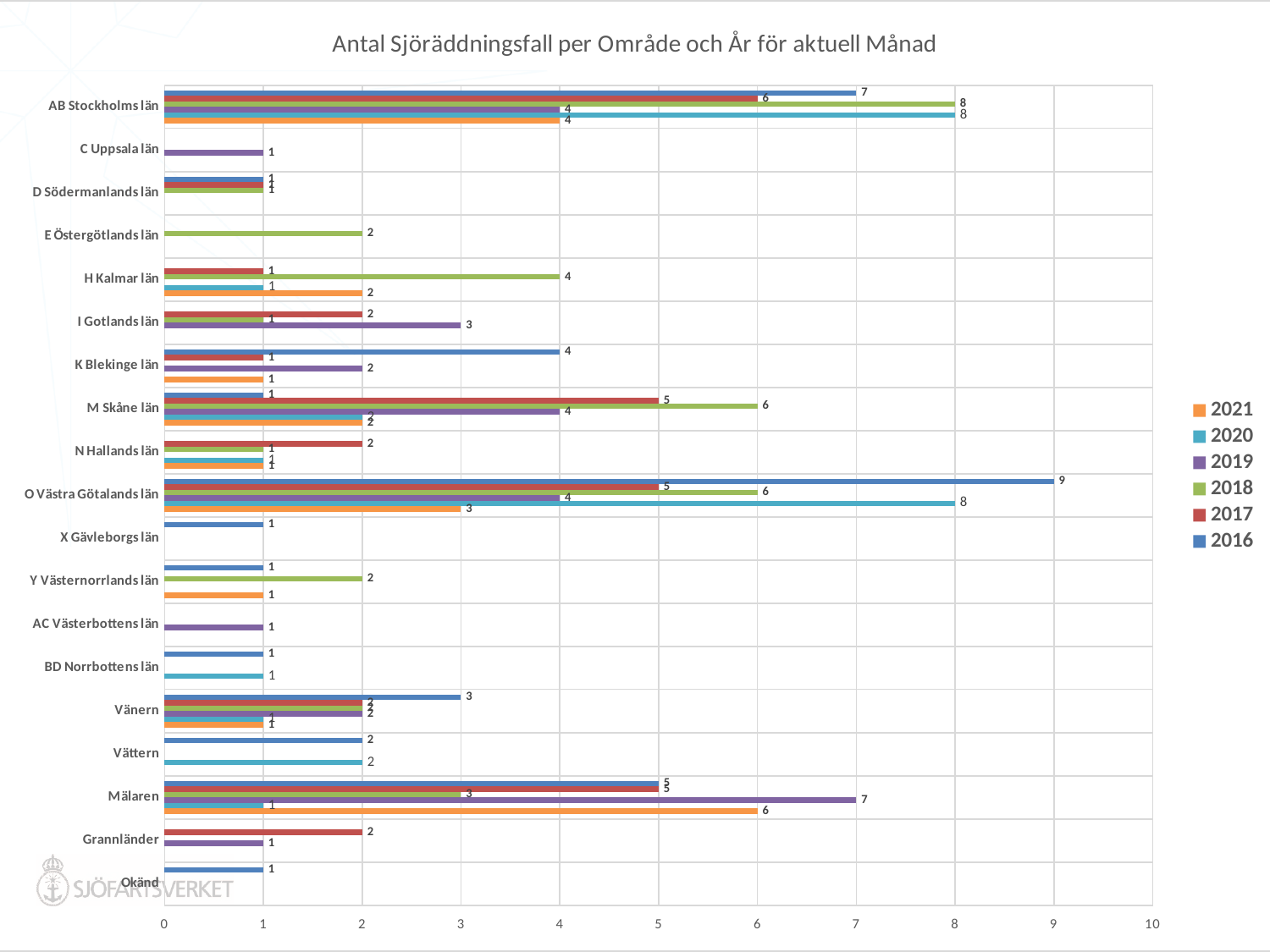
What is the value for M Skåne län in 2018? 6 Which is larger: the 2019 value for Mälaren or the 2019 value for AB Stockholms län? Mälaren Which year is shown in orange in the legend? 2021 How many series does the legend list? 6 Which area has the highest value for 2016? O Västra Götalands län What is the value for AB Stockholms län in 2020? 8 How many areas (categories) are shown on the vertical axis? 19 What is the difference between the 2021 values for Mälaren and O Västra Götalands län? 3 What is the value for O Västra Götalands län in 2016? 9 What is the value for Mälaren in 2019? 7 What kind of chart is shown on the slide? Bar chart What is the title of the chart? Antal Sjöräddningsfall per Område och År för aktuell Månad